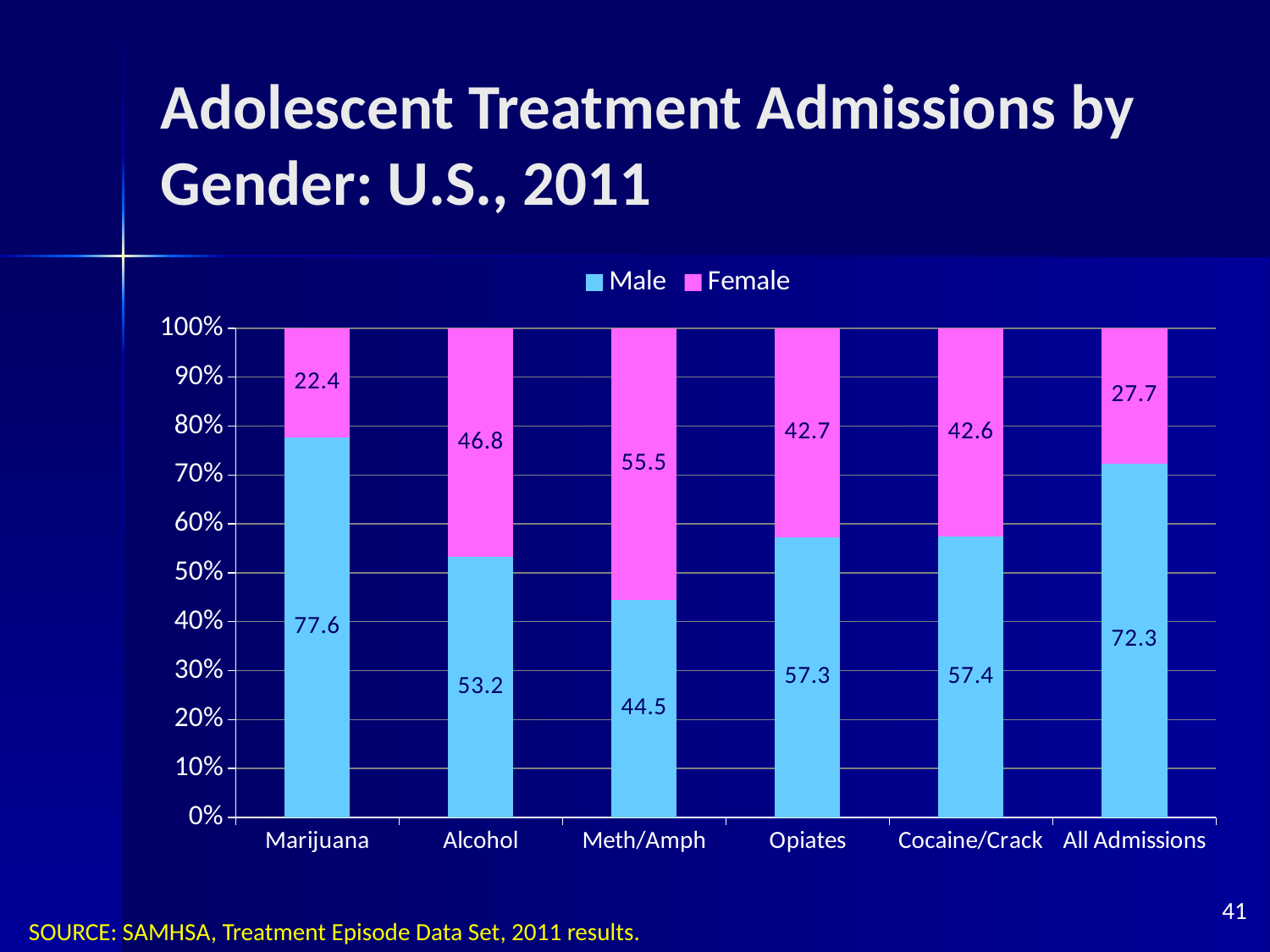
Which is larger, the Male value for Alcohol or the Male value for All Admissions? All Admissions What is the Male value for All Admissions? 72.3 What is the difference between the Male and Female values for Marijuana? 55.2 Which category has the lowest Male value? Meth/Amph Which category has the highest Male value? Marijuana Which category has the highest Female value? Meth/Amph What is the Female value for Opiates? 42.7 What is the Male value for Marijuana? 77.6 How many series does the legend list? 2 What kind of chart is shown on the slide? Stacked bar chart How many categories are shown on the x axis? 6 What is the Female value for Meth/Amph? 55.5